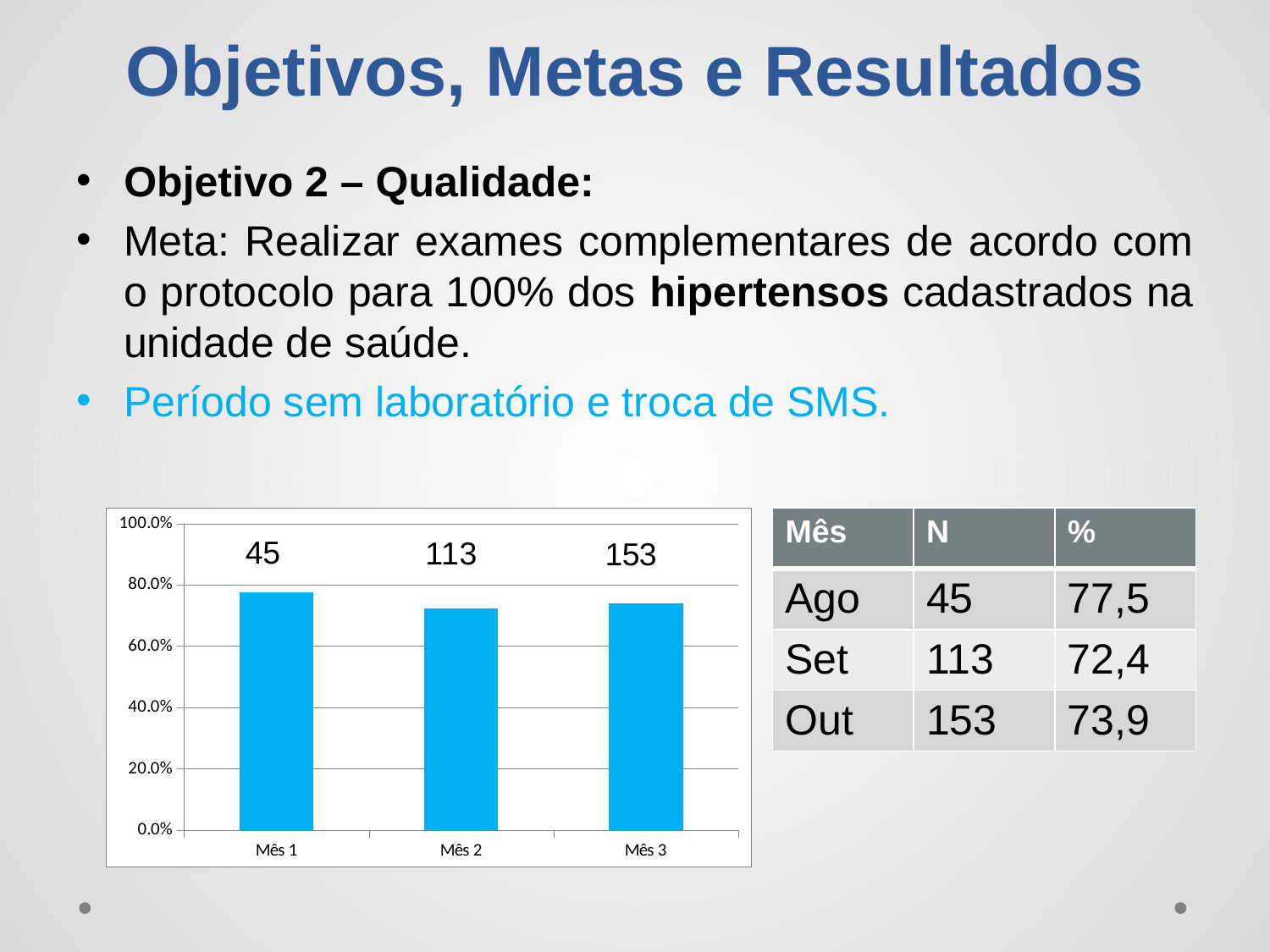
Is the bar for Mês 3 greater or less than 80.0%? less What kind of chart is shown on the slide? bar chart Is the bar for Mês 1 greater or less than 80.0%? less What is the highest value shown on the chart's vertical axis? 100.0% How many bars (categories) does the chart show? 3 What data label is printed above the bar for Mês 3? 153 What data label is printed above the bar for Mês 1? 45 Is the bar for Mês 2 greater or less than 60.0%? greater Which category has the tallest bar? Mês 1 Which bar is taller, Mês 1 or Mês 2? Mês 1 What data label is printed above the bar for Mês 2? 113 From Mês 1 to Mês 2, does the bar height rise or fall? fall